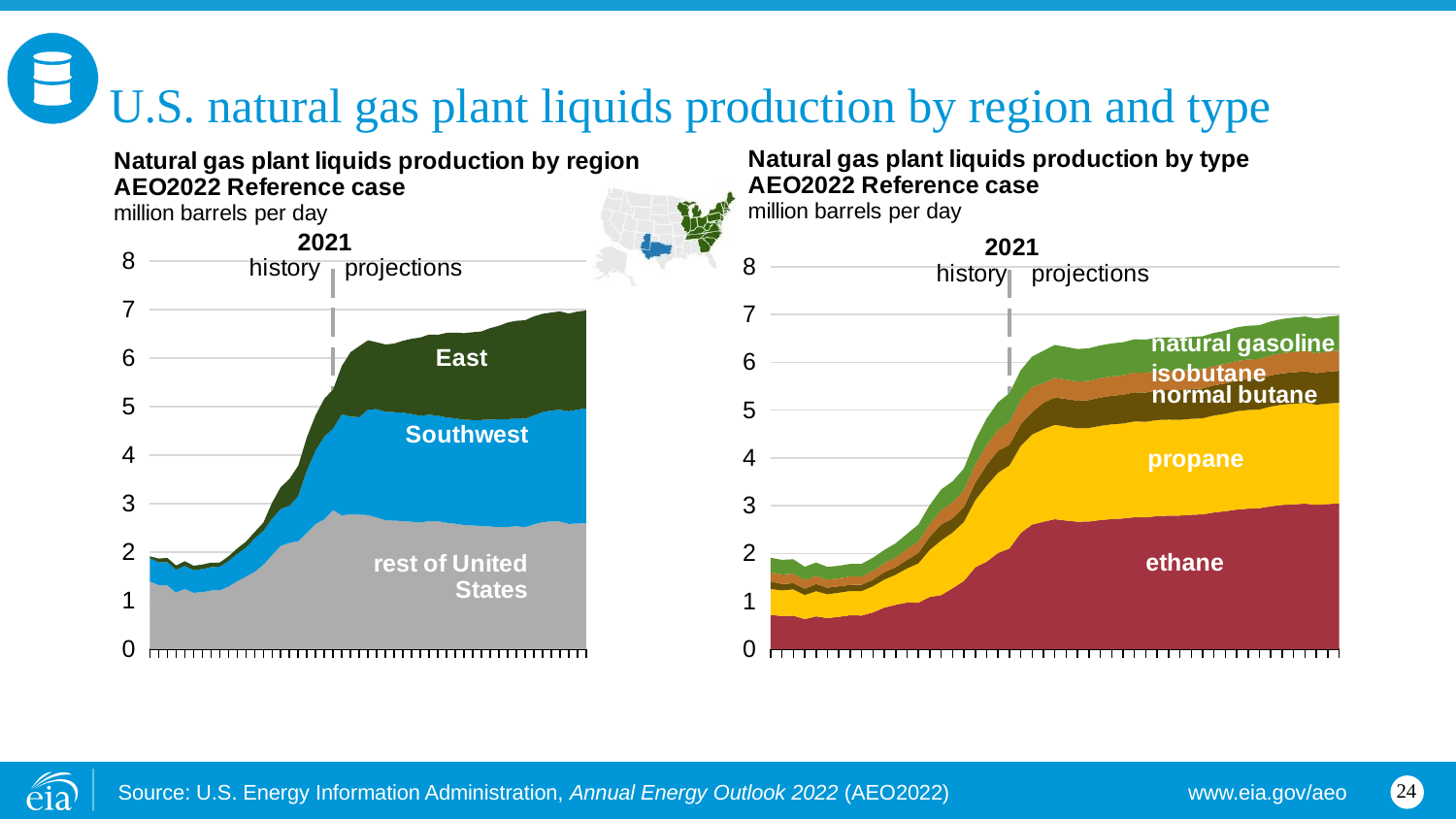
In the right chart by type, which type contributes the smallest share of production at the end of the projection period? isobutane In the right chart by type, is ethane production at the end of the projection period greater or less than 2 million barrels per day? greater In the left chart by region, which region contributes the largest share of production at the end of the projection period? rest of United States How many product types are shown as series in the right chart, 'Natural gas plant liquids production by type'? 5 In the right chart by type, is the ethane band larger or smaller than the propane band at the end of the projection period? larger What kind of chart is the 'Natural gas plant liquids production by region' chart on the left? stacked area chart In the right chart by type, which type contributes the largest share of production at the end of the projection period? ethane How many regions are shown as series in the left chart, 'Natural gas plant liquids production by region'? 3 What unit of measurement is used on the y axis of both charts? million barrels per day In the left chart by region, is total natural gas plant liquids production at the end of the projection period greater or less than 6 million barrels per day? greater What year does the vertical dashed line separating history from projections mark in both charts? 2021 In the left chart by region, does total natural gas plant liquids production rise or fall from the start of the history period to the end of the projections? rise